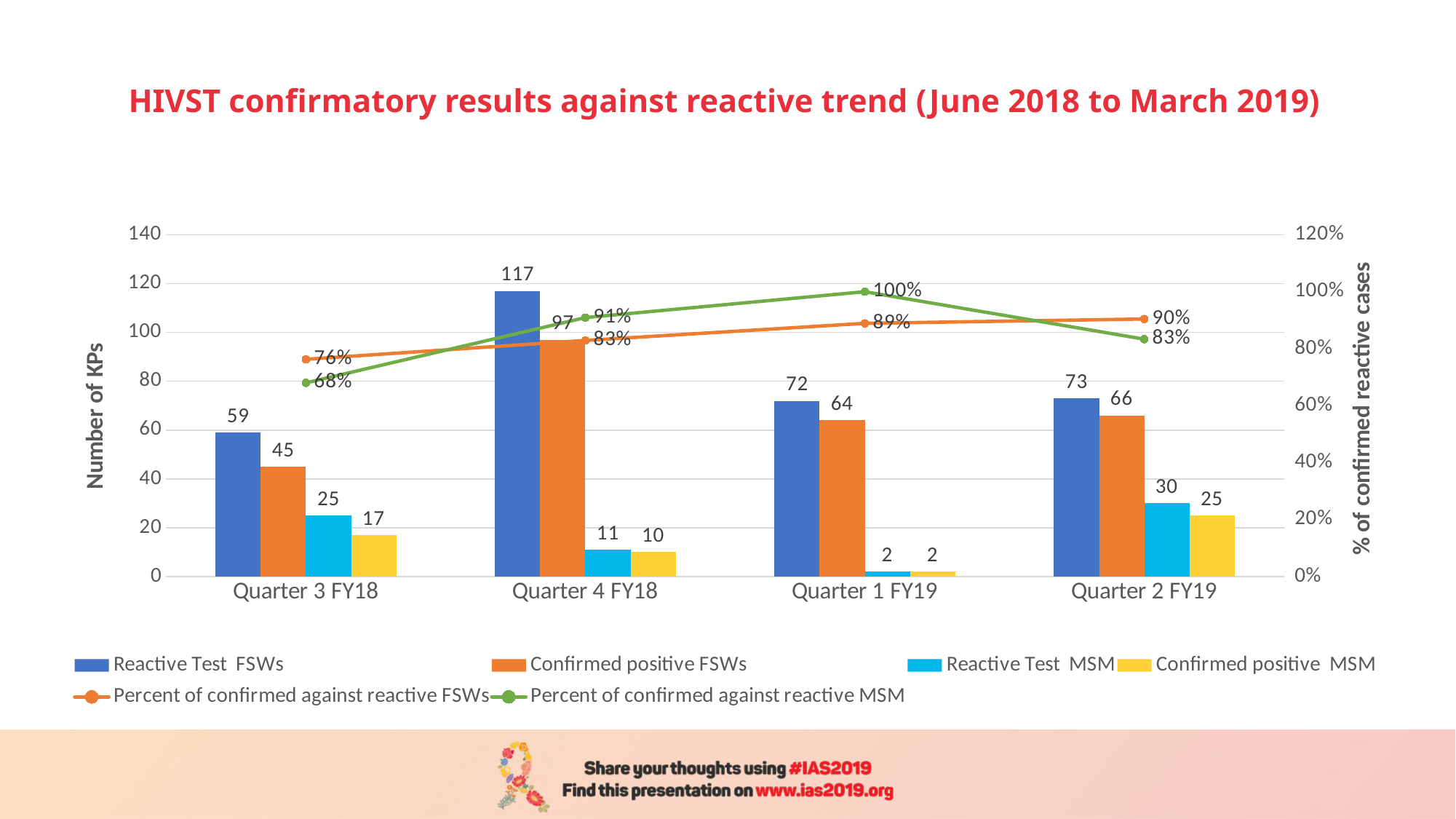
What kind of chart is this? Combined bar and line chart What is the Percent of confirmed against reactive FSWs in Quarter 2 FY19? 90% In which quarter is the Reactive Test FSWs value highest? Quarter 4 FY18 What is the difference between Reactive Test FSWs and Confirmed positive FSWs in Quarter 3 FY18? 14 What is the Percent of confirmed against reactive MSM in Quarter 1 FY19? 100% Which is larger in Quarter 2 FY19: Reactive Test MSM or Confirmed positive MSM? Reactive Test MSM In which quarter is the Reactive Test MSM value lowest? Quarter 1 FY19 What is the value for Confirmed positive MSM in Quarter 3 FY18? 17 What is the label of the left vertical axis? Number of KPs How many quarters are shown on the x axis? 4 What is the value for Reactive Test FSWs in Quarter 4 FY18? 117 How many series does the legend list? 6